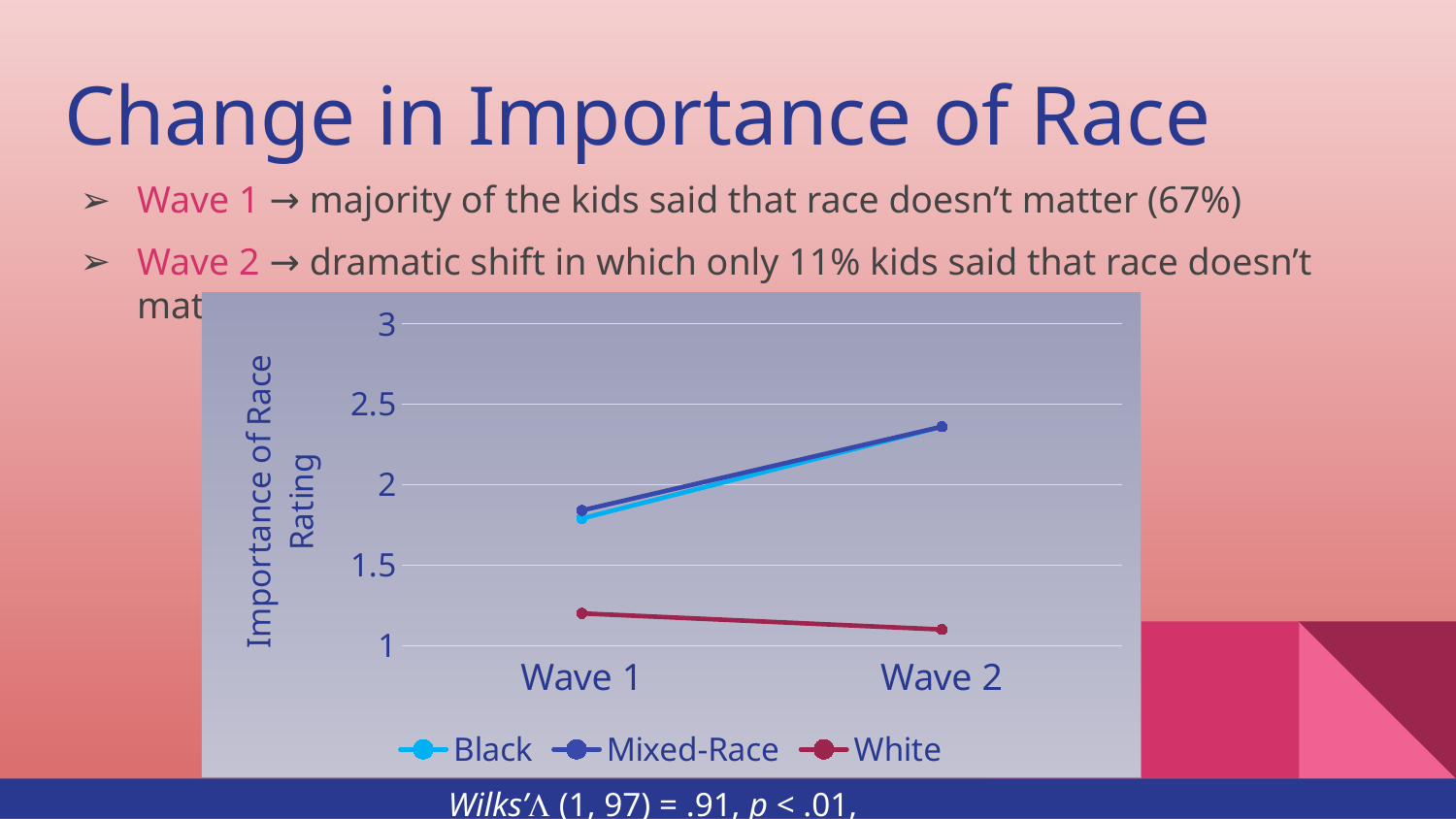
Does the Black series rise or fall from Wave 1 to Wave 2? rise What is the title of the chart's vertical axis? Importance of Race Rating Which series has the lowest value at Wave 1? White What kind of chart is shown on the slide? line chart How many series does the chart's legend list? 3 Which series are listed in the chart's legend? Black, Mixed-Race, White Does the Mixed-Race series rise or fall from Wave 1 to Wave 2? rise Is the value for Black at Wave 1 greater or less than 2? less Does the White series rise or fall from Wave 1 to Wave 2? fall Is the value for Mixed-Race at Wave 2 greater or less than 2? greater How many categories are shown on the x axis of the chart? 2 Is the value for White at Wave 2 greater or less than 1.5? less